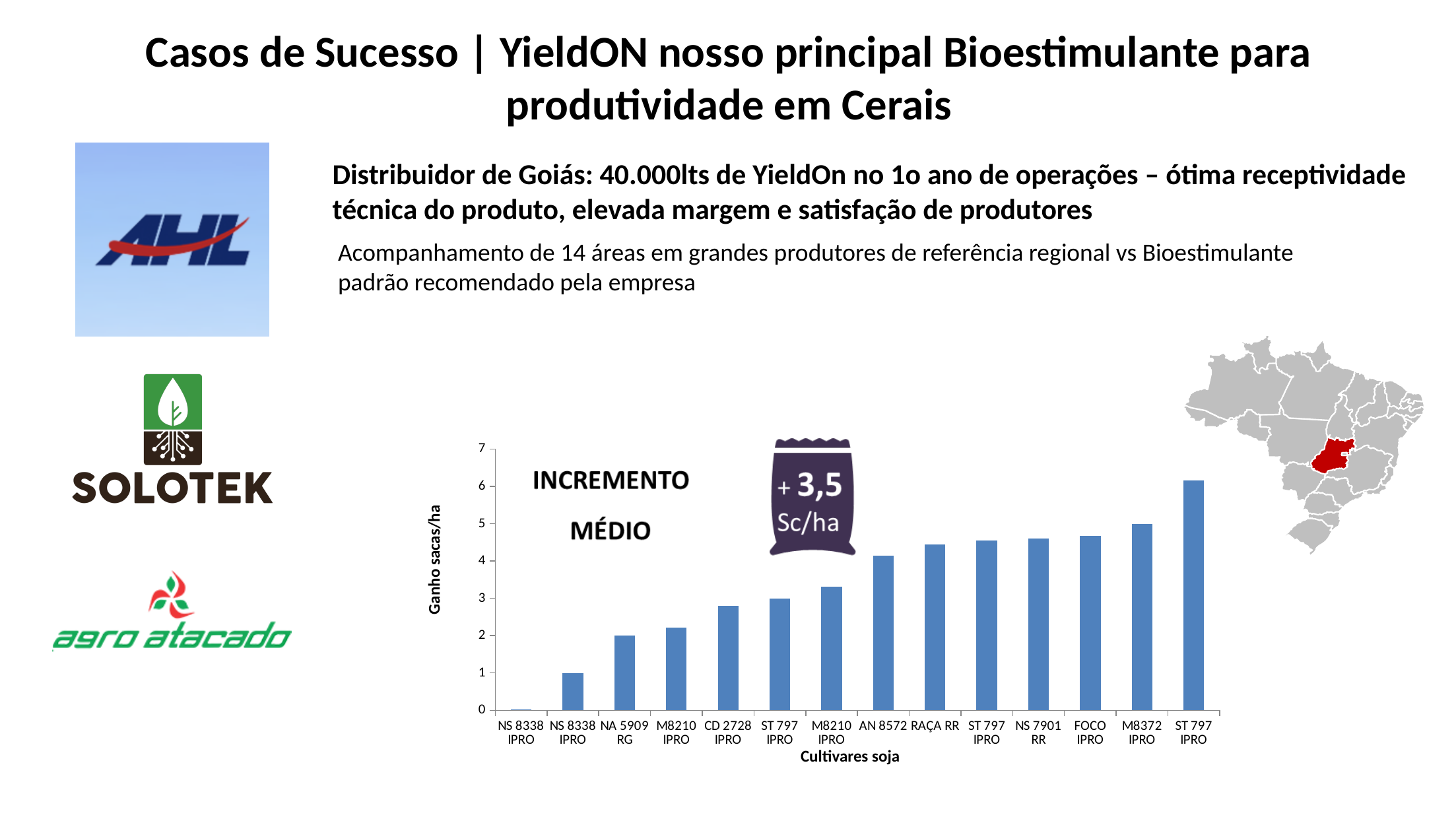
Which cultivar has the highest gain in sacas/ha in the chart? ST 797 IPRO (rightmost bar) Is the value for FOCO IPRO greater or less than 4? greater Is the value for NS 7901 RR greater or less than 5? less Is the value for RAÇA RR greater or less than 4? greater What kind of chart is shown on the slide? bar chart How many cultivar bars are plotted in the chart? 14 Do the bar values rise or fall from left to right along the x axis? rise What is the title of the y axis of the chart? Ganho sacas/ha Which has a larger gain in sacas/ha, FOCO IPRO or NA 5909 RG? FOCO IPRO Which bar in the chart shows the lowest gain in sacas/ha? NS 8338 IPRO (leftmost bar) What average increment (incremento médio) is highlighted in the annotation on the chart? + 3,5 Sc/ha